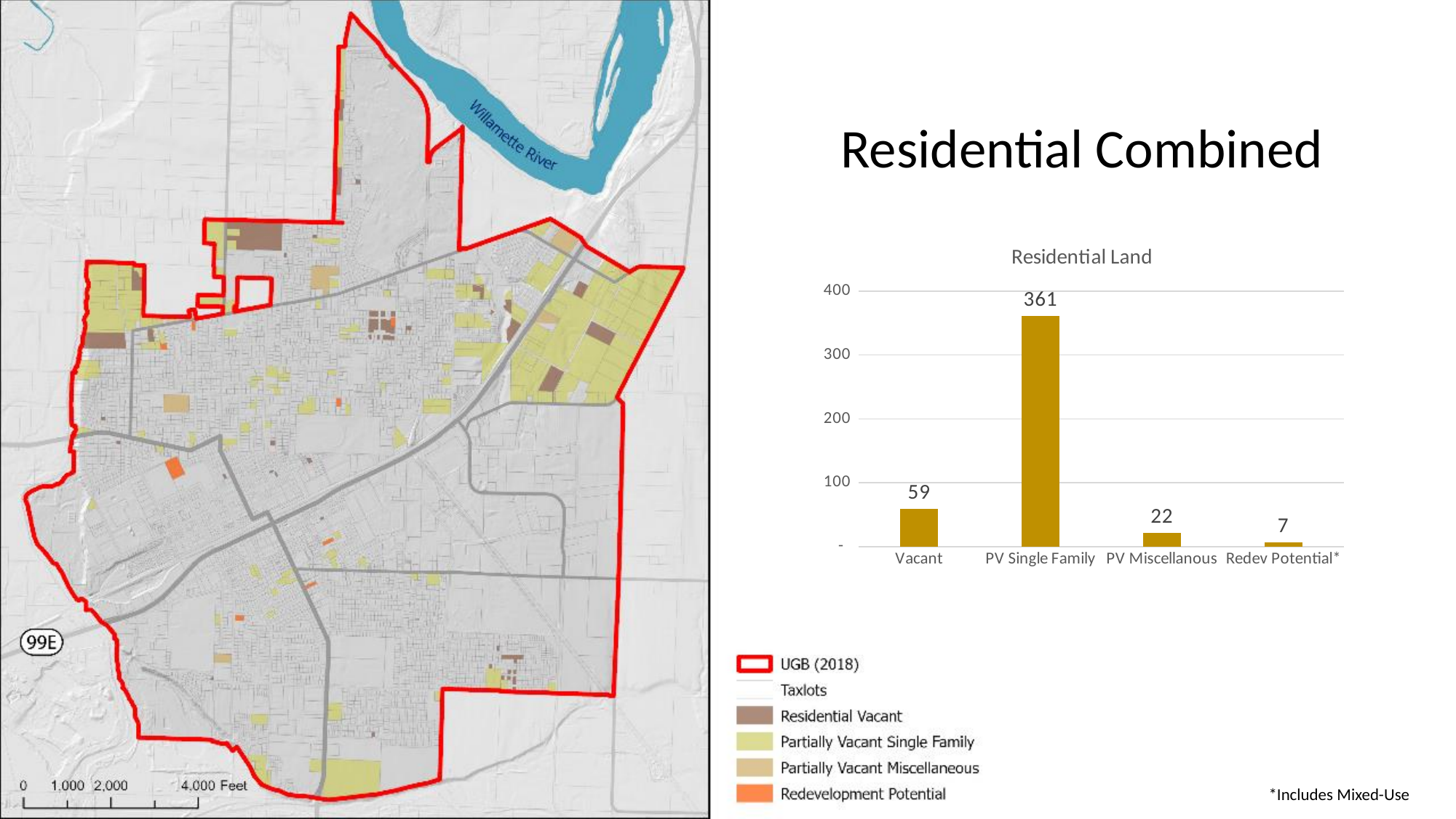
What is the title of the chart on the slide? Residential Land What is the value for Redev Potential* in the Residential Land chart? 7 What is the difference between the values for PV Single Family and Vacant in the Residential Land chart? 302 Which category has the lowest value in the Residential Land chart? Redev Potential* Which category has the highest value in the Residential Land chart? PV Single Family How many categories are shown in the Residential Land chart? 4 What is the value for Vacant in the Residential Land chart? 59 Is the value for Vacant in the Residential Land chart greater or less than 100? less Which is larger in the Residential Land chart, Vacant or PV Miscellanous? Vacant What is the value for PV Miscellanous in the Residential Land chart? 22 What kind of chart is the Residential Land chart? bar chart What is the value for PV Single Family in the Residential Land chart? 361